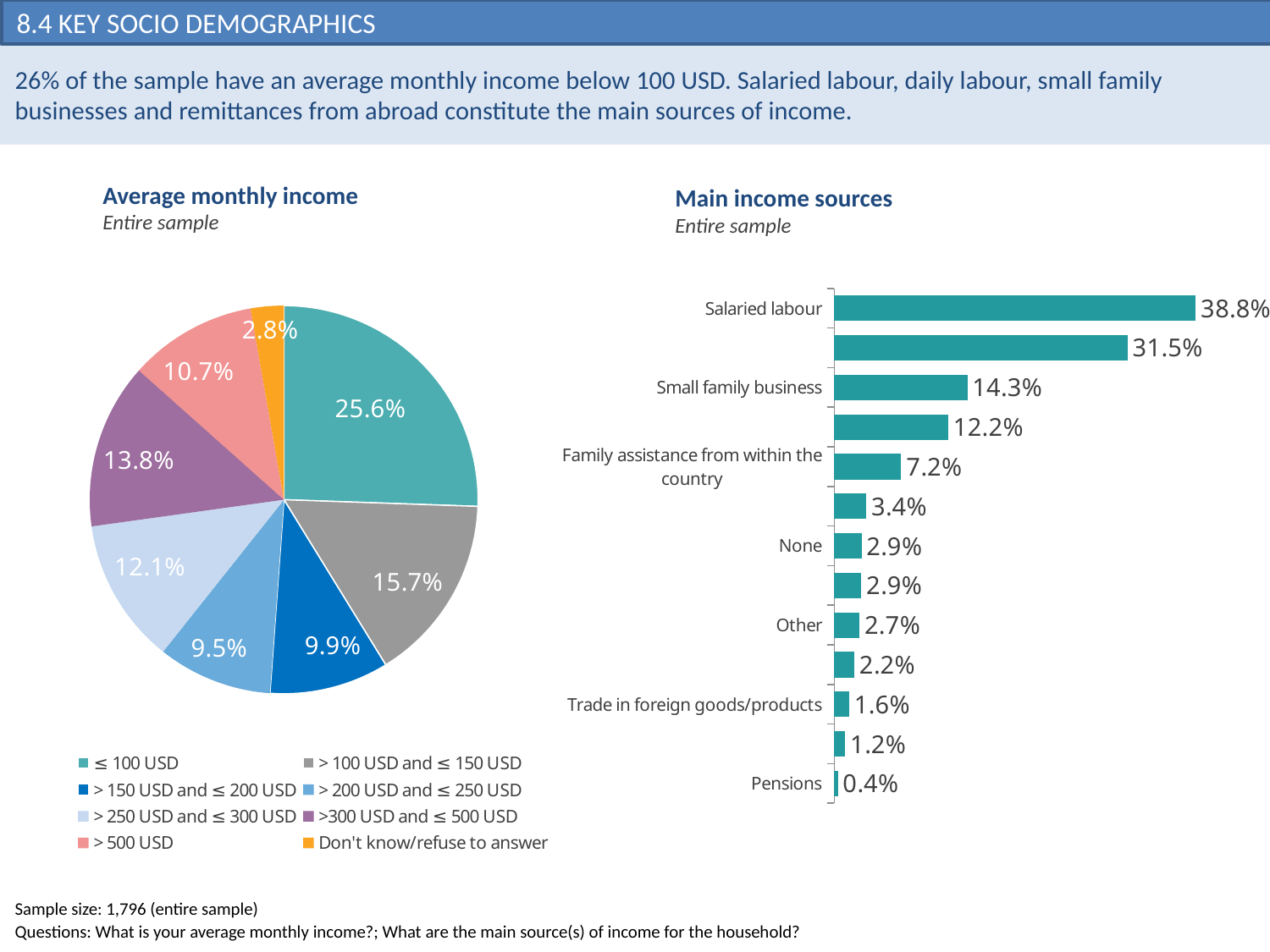
In the Main income sources chart, what is the value for Pensions? 0.4% What type of chart is the Main income sources chart? Bar chart In the Average monthly income pie chart, what percentage answered Don't know/refuse to answer? 2.8% In the Main income sources chart, which is larger: Family assistance from within the country or Trade in foreign goods/products? Family assistance from within the country In the Average monthly income pie chart, what percentage falls in the > 100 USD and ≤ 150 USD category? 15.7% In the Main income sources chart, what is the value for Small family business? 14.3% In the Main income sources chart, what is the value for Salaried labour? 38.8% In the Average monthly income pie chart, how many categories does the legend list? 8 In the Average monthly income pie chart, what is the difference between the > 500 USD slice and the > 200 USD and ≤ 250 USD slice? 1.2% In the Average monthly income pie chart, which category has the largest slice? ≤ 100 USD In the Main income sources chart, which category has the lowest value? Pensions In the Average monthly income pie chart, what share of the sample has an income of ≤ 100 USD? 25.6%